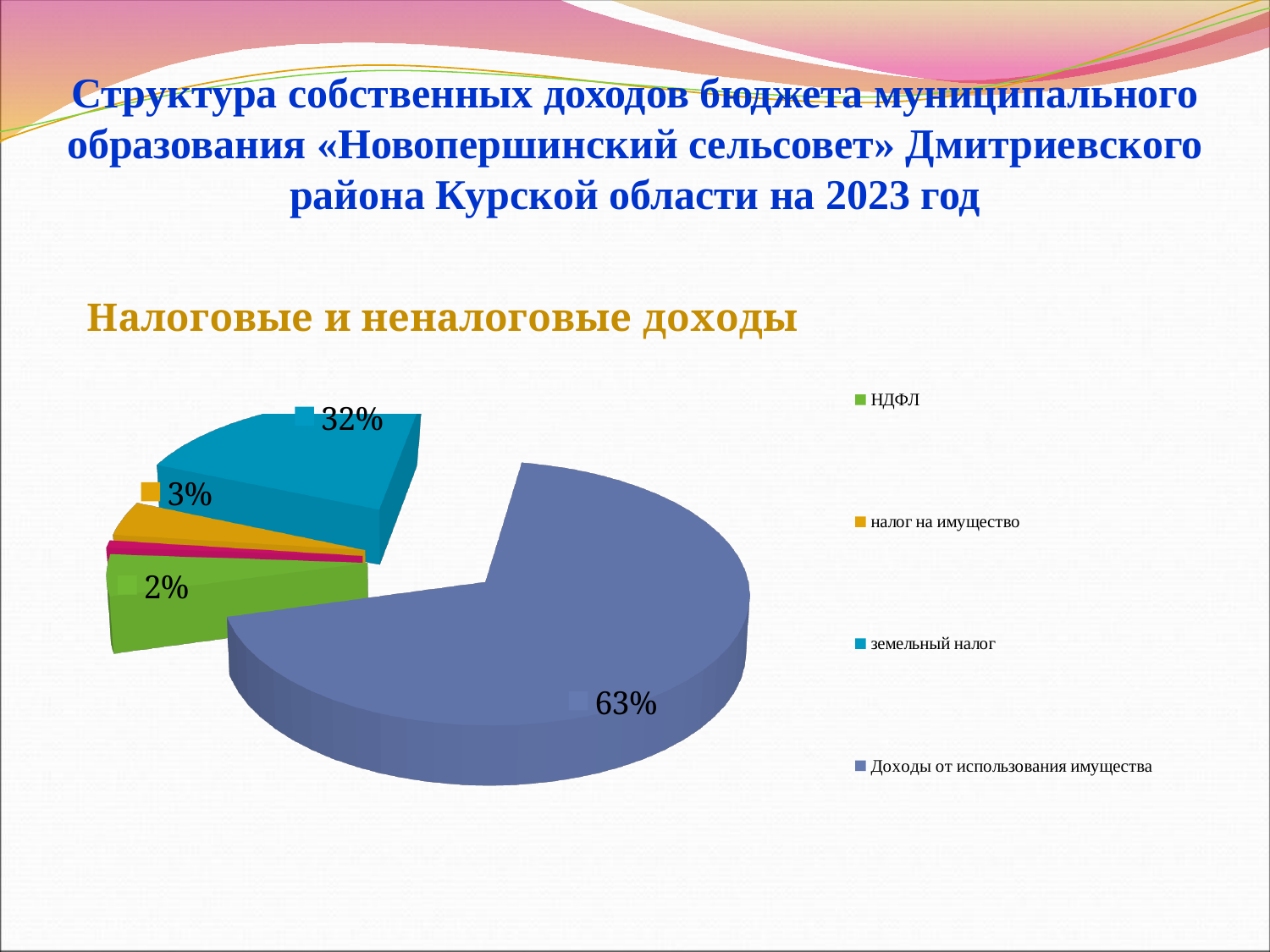
What share of the pie does Доходы от использования имущества have? 63% How many entries does the legend list? 4 Which is larger, the slice for Доходы от использования имущества or the slice for земельный налог? Доходы от использования имущества What is the difference in percentage points between the Доходы от использования имущества slice and the земельный налог slice? 31 What is the title of the chart? Налоговые и неналоговые доходы What share of the pie does земельный налог have? 32% What share of the pie does НДФЛ have? 2% What type of chart is shown on the slide? pie chart Which category has the largest slice of the pie? Доходы от использования имущества Which is larger, the slice for земельный налог or the slice for налог на имущество? земельный налог What share of the pie does налог на имущество have? 3% What colour is the slice for земельный налог? cyan (light blue)